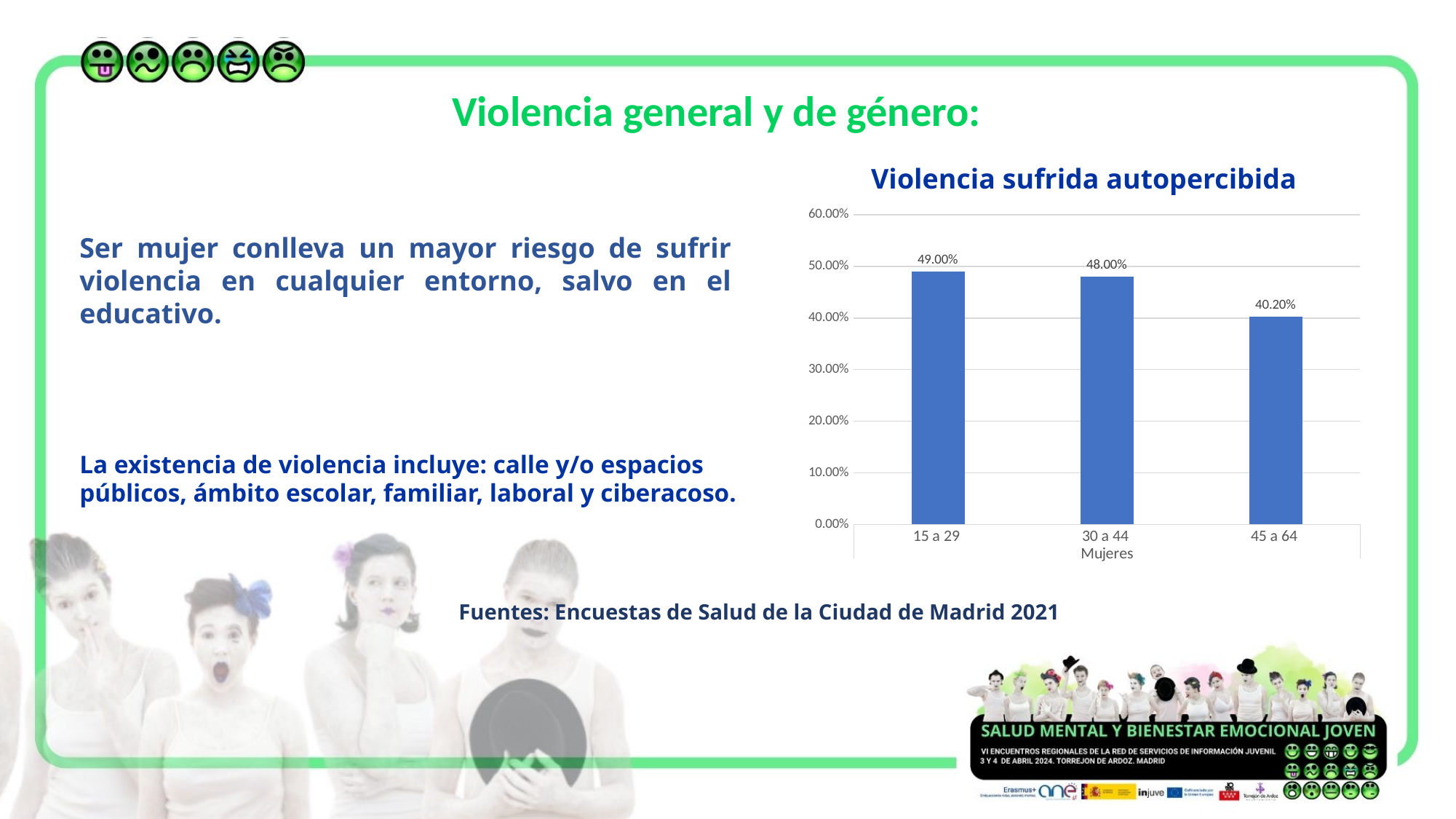
How many age groups are shown in the chart? 3 Which age group has the highest value in the chart? 15 a 29 What is the difference between the values for 30 a 44 and 45 a 64? 7.80% Which age group has the lowest value in the chart? 45 a 64 What is the value for the 45 a 64 age group? 40.20% Do the values rise or fall as the age groups increase along the x axis? fall What is the difference between the values for 15 a 29 and 45 a 64? 8.80% Is the value for 45 a 64 greater or less than 50.00%? less What is the value for the 30 a 44 age group? 48.00% What is the value for the 15 a 29 age group in the Violencia sufrida autopercibida chart? 49.00% Which is larger, the value for 30 a 44 or the value for 45 a 64? 30 a 44 What kind of chart is shown on the slide? bar chart